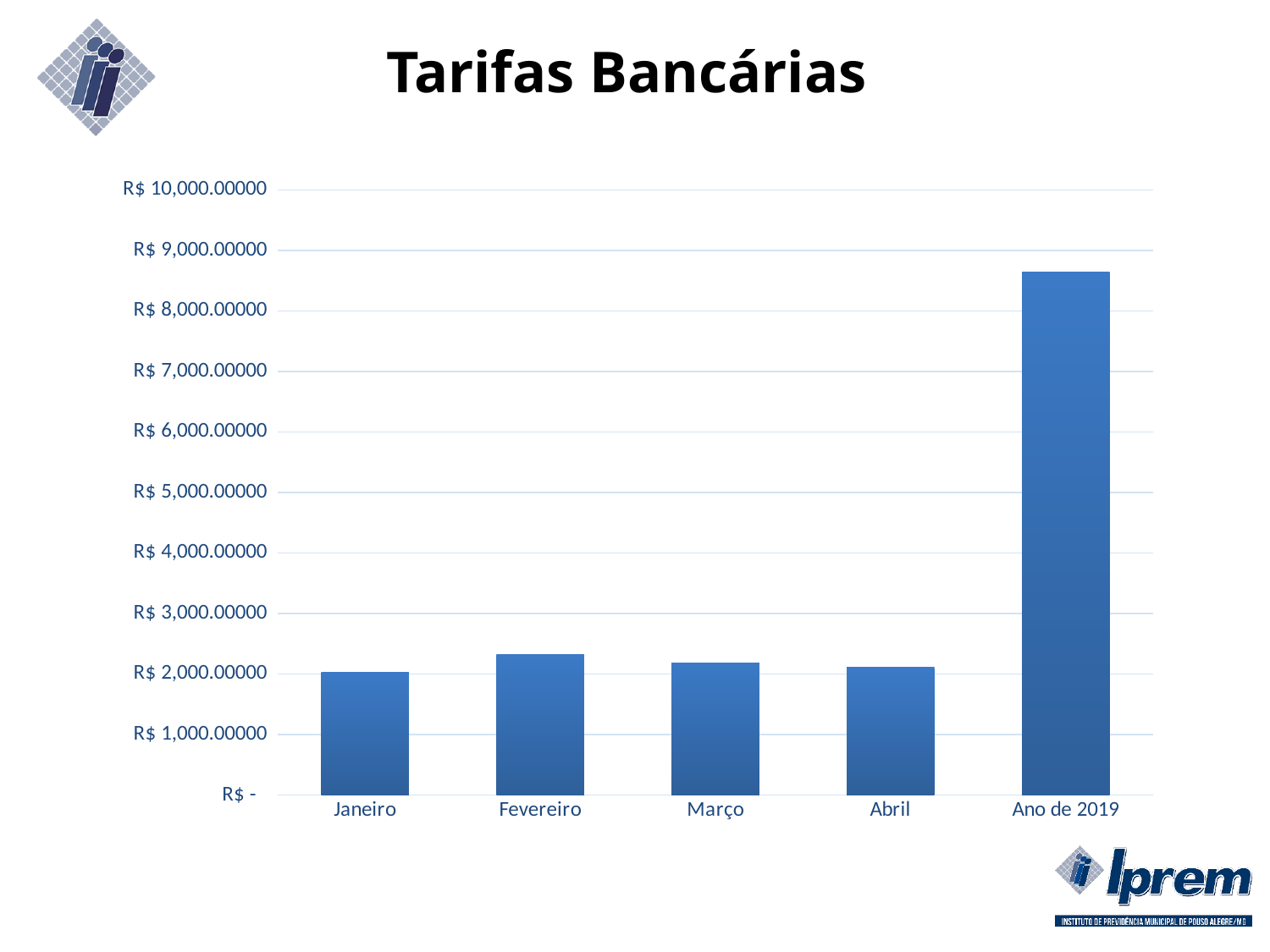
How many categories are shown on the x axis of the chart? 5 Which is larger, the value for Ano de 2019 or the value for Abril? Ano de 2019 Is the value for Fevereiro greater or less than R$ 2,000.00000? greater What kind of chart is shown on the slide? bar chart Is the value for Abril greater or less than R$ 3,000.00000? less What is the title of the chart? Tarifas Bancárias Is the value for Março greater or less than R$ 1,000.00000? greater Which is larger, the value for Fevereiro or the value for Janeiro? Fevereiro Which category has the highest value in the chart? Ano de 2019